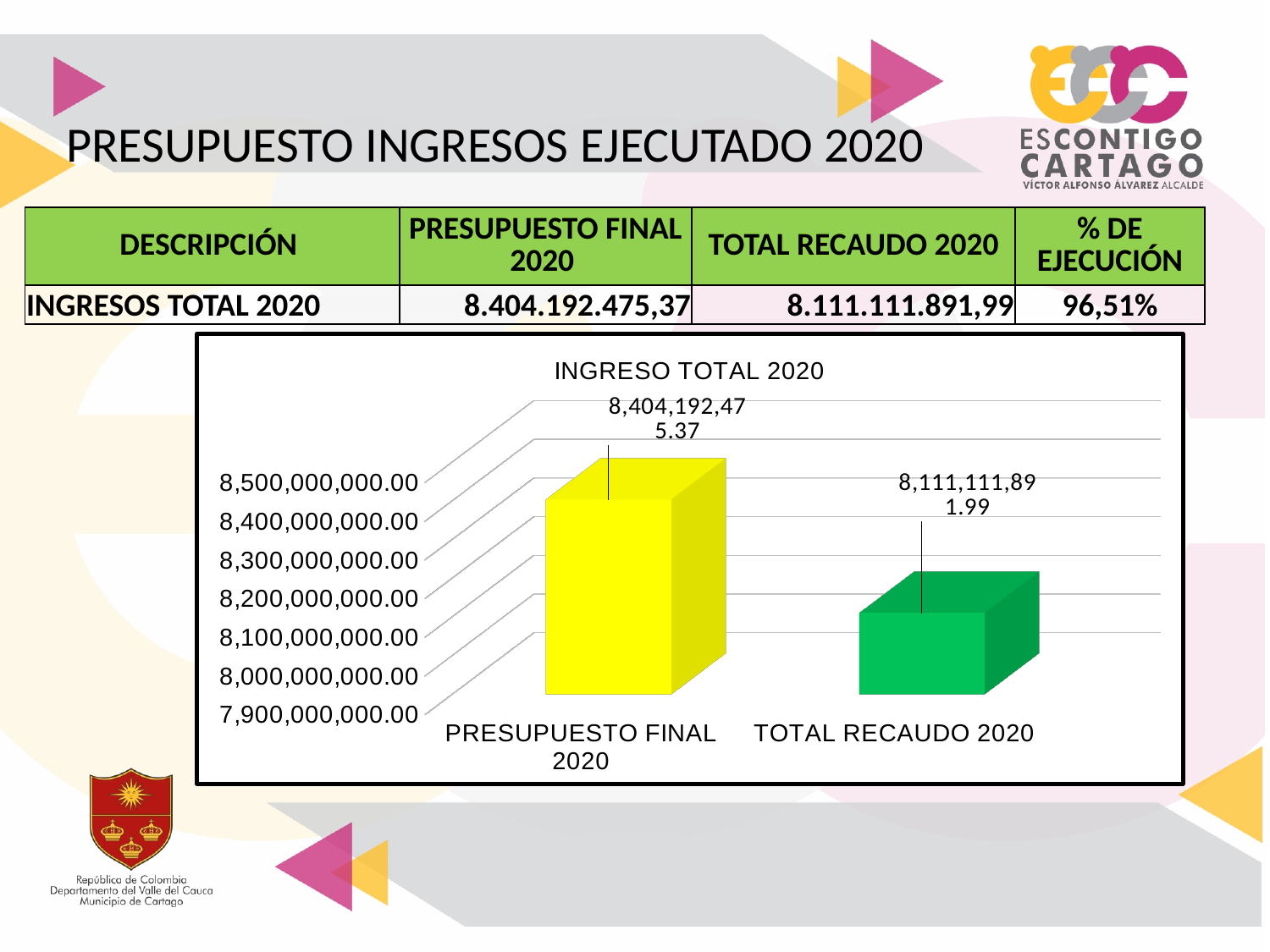
Which category has the lowest value in the chart? TOTAL RECAUDO 2020 What is the value shown for PRESUPUESTO FINAL 2020 in the chart? 8,404,192,475.37 What colour is the bar for TOTAL RECAUDO 2020? green What is the title of the chart? INGRESO TOTAL 2020 What is the value shown for TOTAL RECAUDO 2020 in the chart? 8,111,111,891.99 Is the value for TOTAL RECAUDO 2020 greater or less than 8,200,000,000.00? less Which is larger, PRESUPUESTO FINAL 2020 or TOTAL RECAUDO 2020? PRESUPUESTO FINAL 2020 How many bars (categories) does the chart show? 2 Is the value for PRESUPUESTO FINAL 2020 greater or less than 8,300,000,000.00? greater What is the difference between PRESUPUESTO FINAL 2020 and TOTAL RECAUDO 2020 in the chart? 293,080,583.38 What type of chart is shown on the slide? bar chart Which category has the highest value in the chart? PRESUPUESTO FINAL 2020